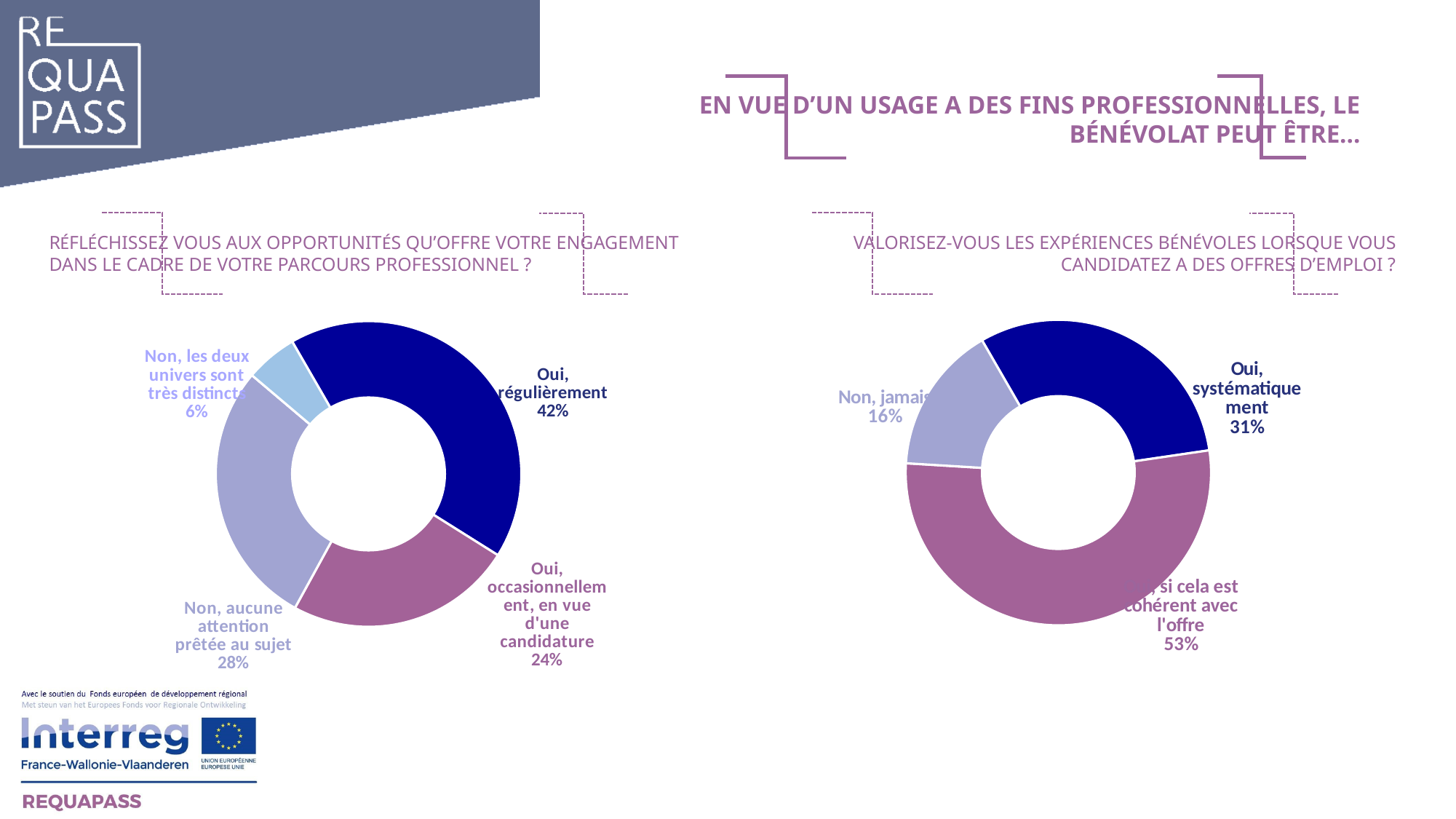
How many slices does the right chart have? 3 How many slices does the left chart have? 4 In the right chart, what share of respondents answered "Non, jamais"? 16% In the left chart, which category has the smallest share? Non, les deux univers sont très distincts In the right chart, what percentage corresponds to "Oui, si cela est cohérent avec l'offre"? 53% In the left chart, what is the difference in percentage points between "Oui, régulièrement" and "Oui, occasionnellement, en vue d'une candidature"? 18 What type of chart is used on the right side of the slide? Doughnut (pie) chart In the right chart, which is larger: "Oui, systématiquement" or "Non, jamais"? Oui, systématiquement In the right chart, what is the difference in percentage points between "Oui, si cela est cohérent avec l'offre" and "Oui, systématiquement"? 22 In the left chart, what percentage corresponds to "Non, aucune attention prêtée au sujet"? 28% In the left chart, which category has the largest share? Oui, régulièrement In the left chart, what share of respondents answered "Oui, régulièrement"? 42%